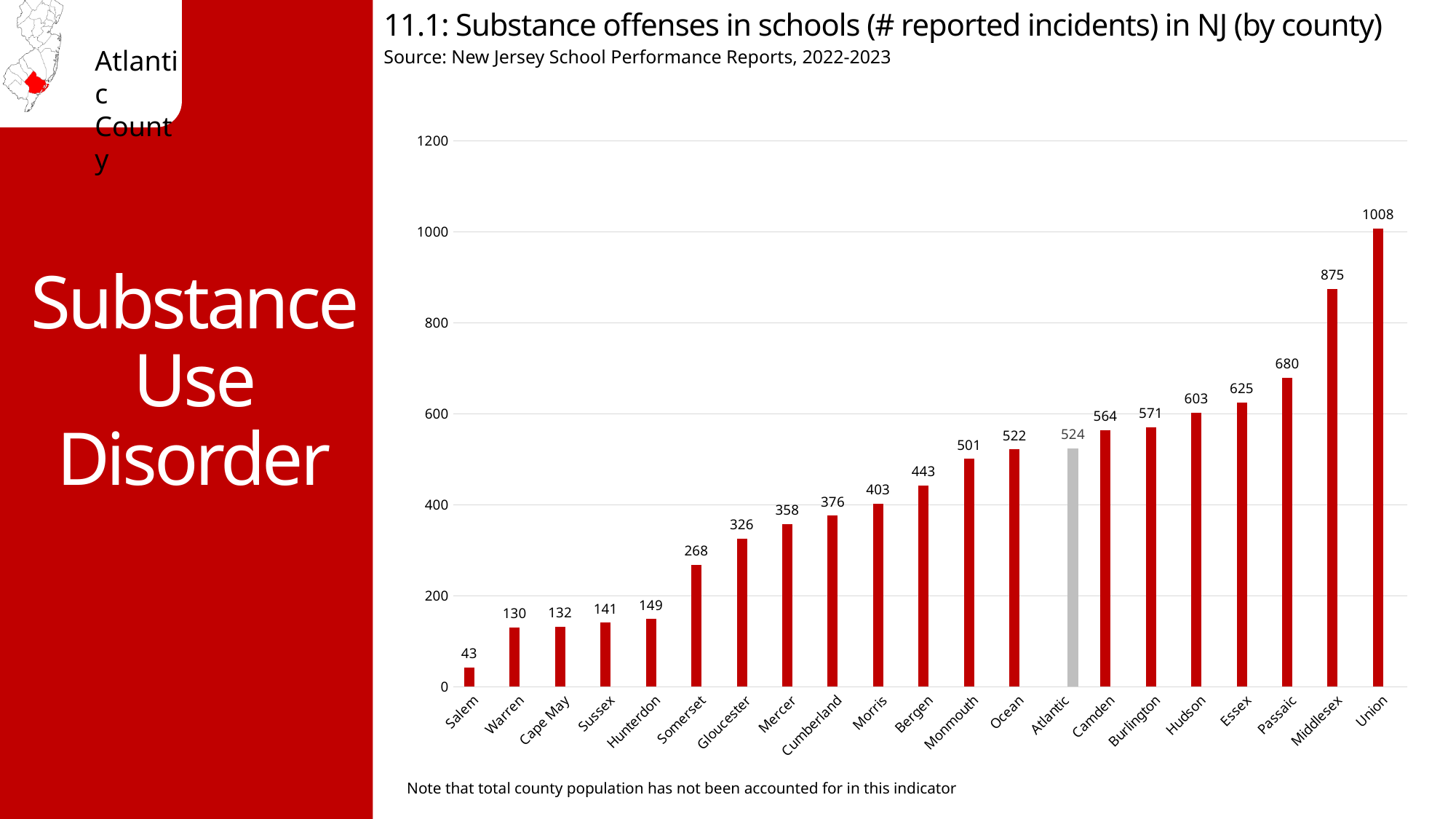
What is the difference between the values for Union and Middlesex? 133 What is the value shown for Union County? 1008 Which county's bar is shown in grey rather than red? Atlantic What kind of chart is shown on the slide? Bar chart How many counties are shown on the chart? 21 Which county has the lowest number of reported incidents? Salem What is the value shown for Gloucester County? 326 Which has a higher value, Camden or Monmouth? Camden Which county has the highest number of reported incidents? Union Is the value for Passaic greater or less than 600? greater What is the difference between the values for Atlantic and Ocean? 2 What is the number of reported substance offense incidents in schools for Atlantic County? 524